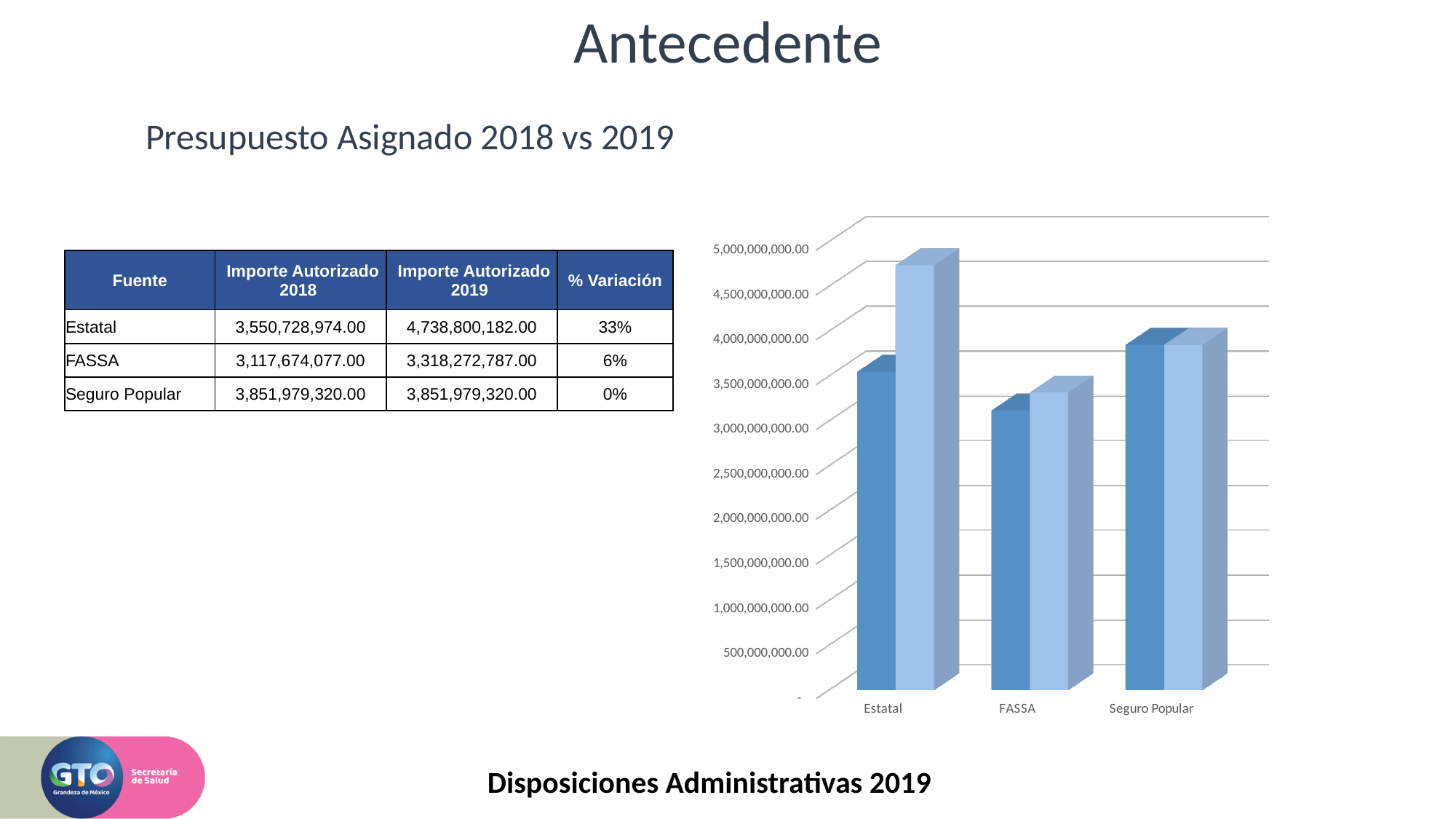
Which is larger in the chart: the first (2018) bar for FASSA or the first (2018) bar for Seguro Popular? Seguro Popular Is the value of the taller (2019) bar for Estatal greater or less than 4,500,000,000.00? greater What heading appears above the table and chart on the slide? Presupuesto Asignado 2018 vs 2019 Is the value of the first (2018) bar for FASSA greater or less than 3,500,000,000.00? less Are the bars for Seguro Popular greater or less than 4,000,000,000.00? less What kind of chart is shown on the right of the slide? bar chart Which is larger in the chart: the second (2019) bar for Estatal or the second (2019) bar for Seguro Popular? Estatal Which category has the shortest bar in the chart? FASSA How many categories are shown on the x axis of the chart? 3 How many bars are drawn for each category in the chart? 2 Which category has the tallest bar in the chart? Estatal